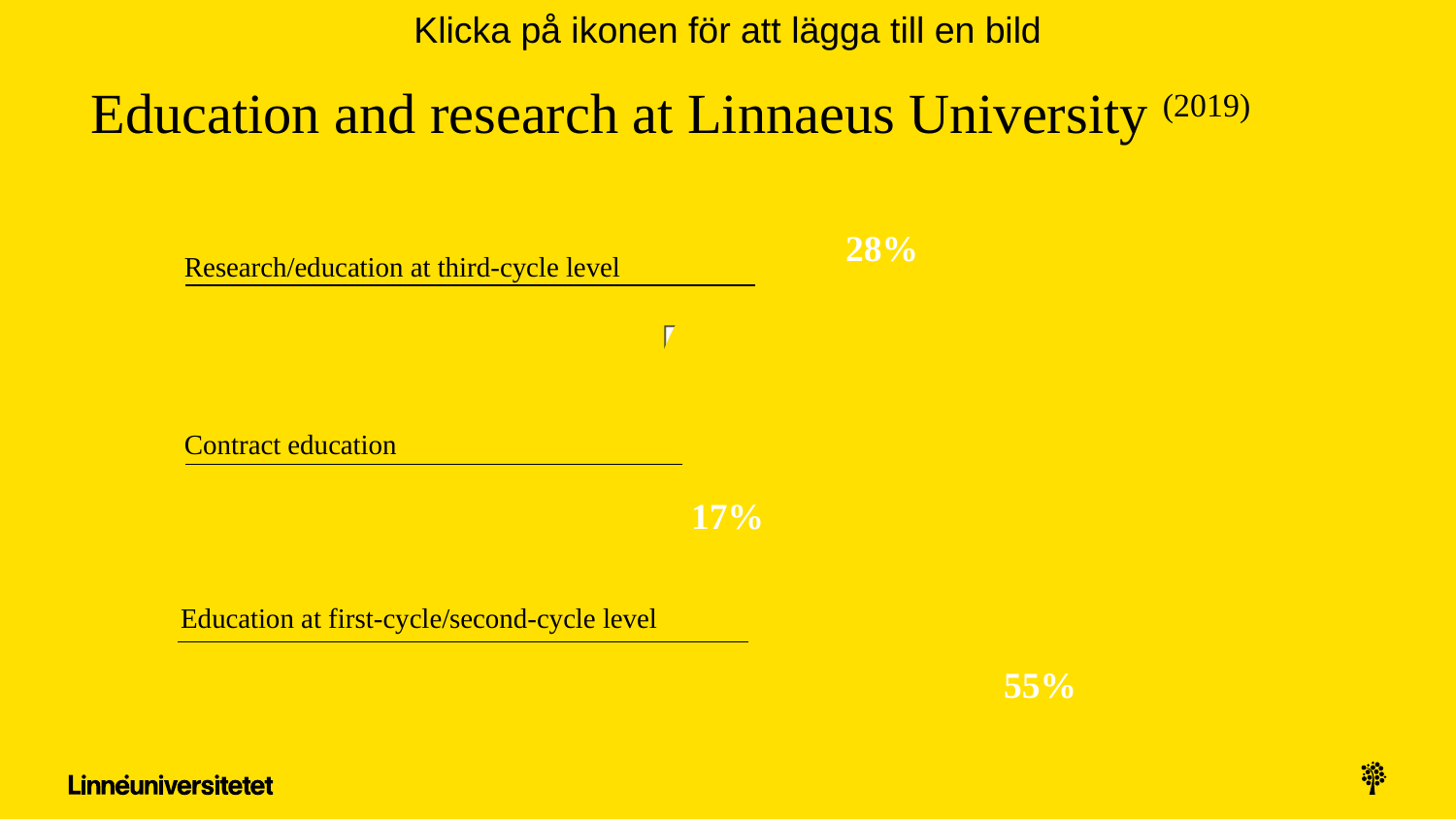
What year is given in the slide title? 2019 What do the three percentages on the chart add up to? 100% What percentage is shown for Contract education? 17% How many categories are labelled on the chart? 3 Which category has the highest percentage? Education at first-cycle/second-cycle level What percentage is shown for Research/education at third-cycle level? 28% What is the difference in percentage points between Research/education at third-cycle level and Contract education? 11 What is the difference in percentage points between Education at first-cycle/second-cycle level and Research/education at third-cycle level? 27 What is the title of the slide? Education and research at Linnaeus University (2019) What percentage is shown for Education at first-cycle/second-cycle level? 55% Which is larger, the percentage for Contract education or for Research/education at third-cycle level? Research/education at third-cycle level Which category has the lowest percentage? Contract education